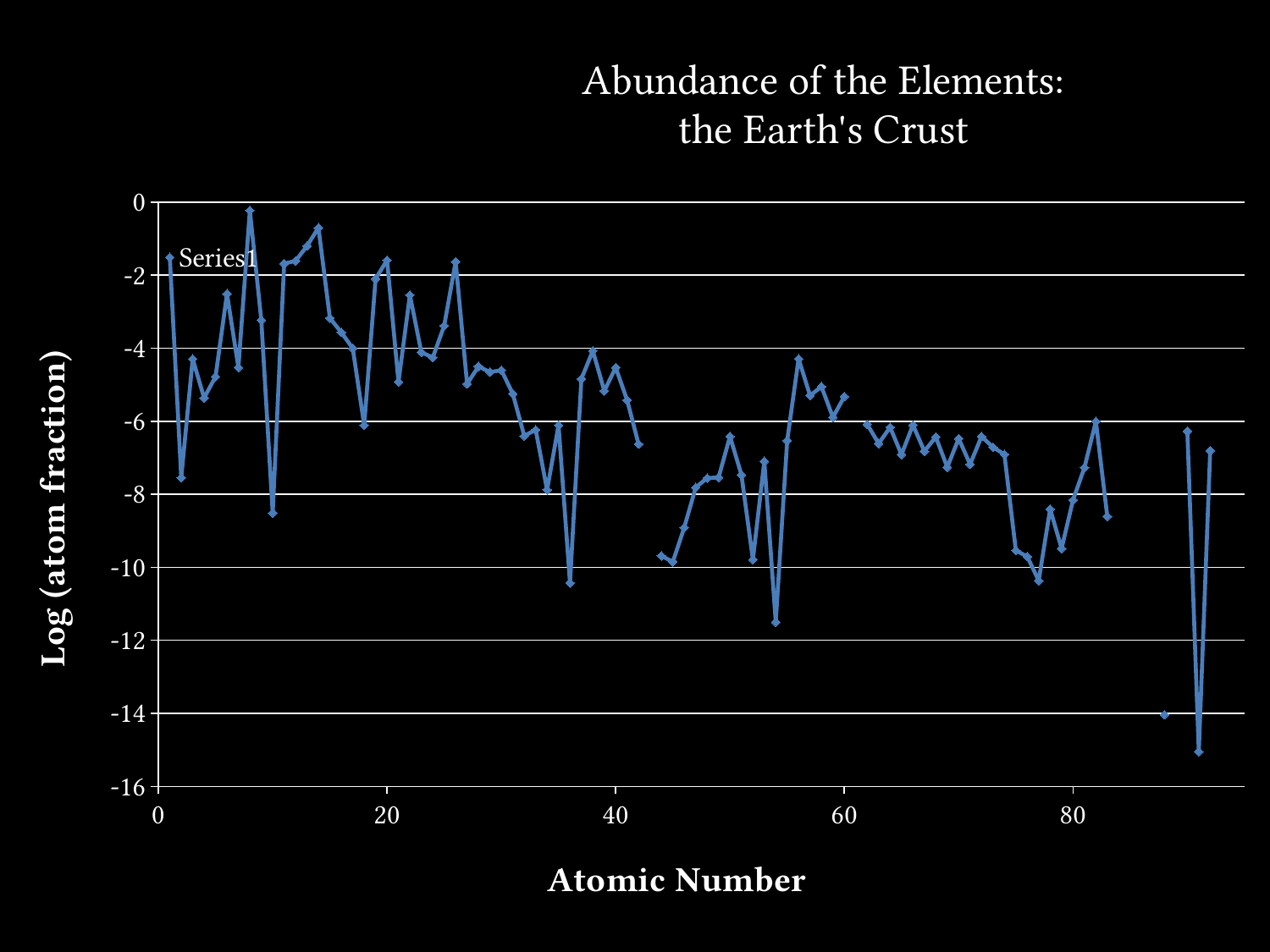
Which has the larger value, atomic number 8 or atomic number 10? atomic number 8 Is the value for atomic number 8 greater or less than -2? greater What kind of chart is shown on the slide? line chart Is the value for atomic number 10 greater or less than -8? less Is the value for atomic number 91 greater or less than -14? less Overall, do the plotted values rise or fall as the atomic number increases? fall What is the label on the x axis of the chart? Atomic Number What is the title of the chart? Abundance of the Elements: the Earth's Crust At which atomic number does the chart reach its highest value? 8 At which atomic number does the chart reach its lowest value? 91 How many series does the chart plot? 1